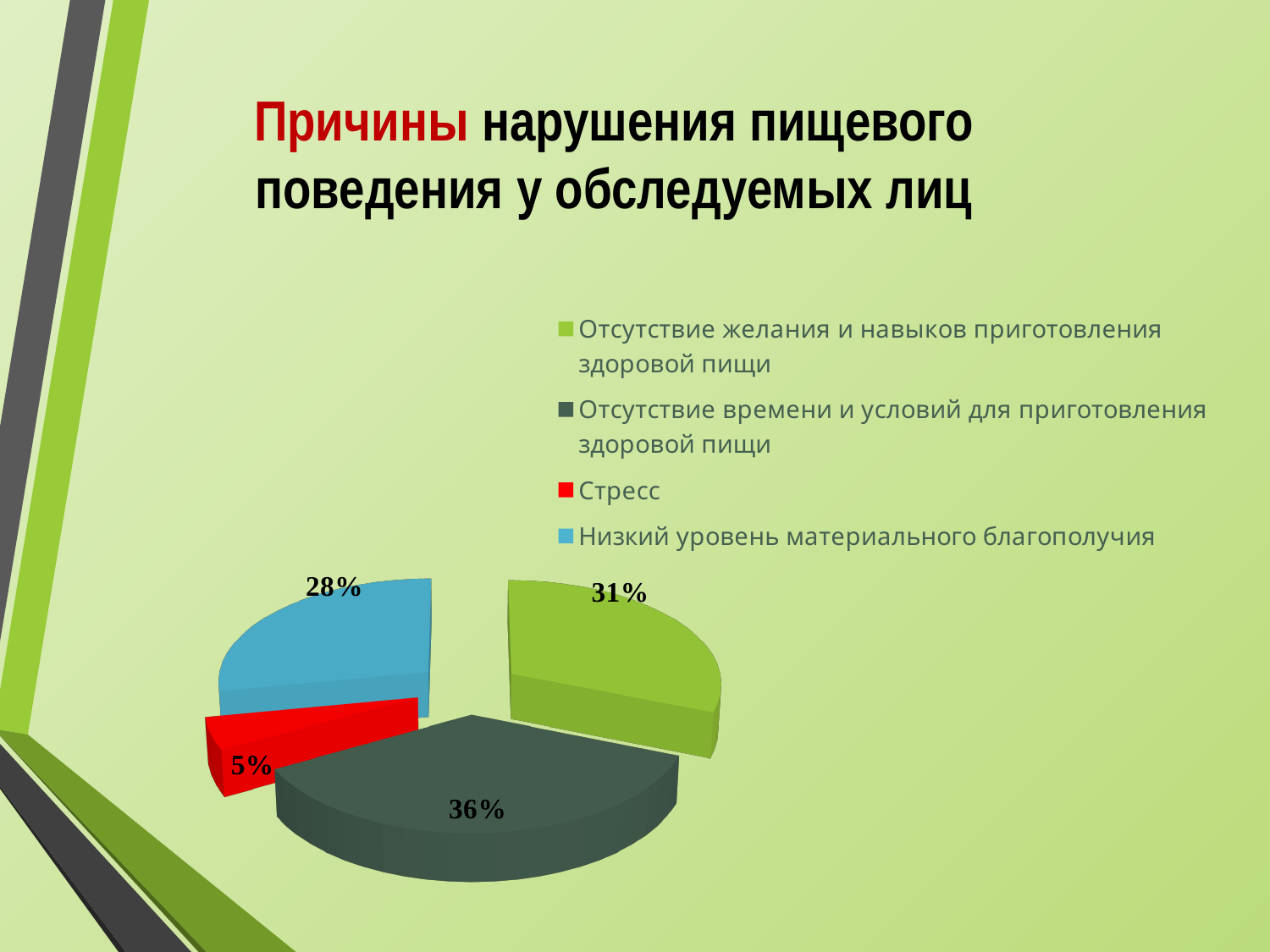
What is the title of the slide containing the chart? Причины нарушения пищевого поведения у обследуемых лиц Which is larger: the share for "Низкий уровень материального благополучия" or the share for "Стресс"? Низкий уровень материального благополучия What is the difference in percentage points between "Отсутствие времени и условий для приготовления здоровой пищи" and "Отсутствие желания и навыков приготовления здоровой пищи"? 5 What percentage of the pie corresponds to "Стресс"? 5% What percentage is shown for "Отсутствие времени и условий для приготовления здоровой пищи"? 36% What percentage is shown for "Отсутствие желания и навыков приготовления здоровой пищи"? 31% What colour is the slice for "Стресс"? red Which cause has the smallest share of the pie? Стресс Which cause has the largest share of the pie? Отсутствие времени и условий для приготовления здоровой пищи How many slices does the pie chart have? 4 What kind of chart is shown on the slide? pie chart What percentage is shown for "Низкий уровень материального благополучия"? 28%